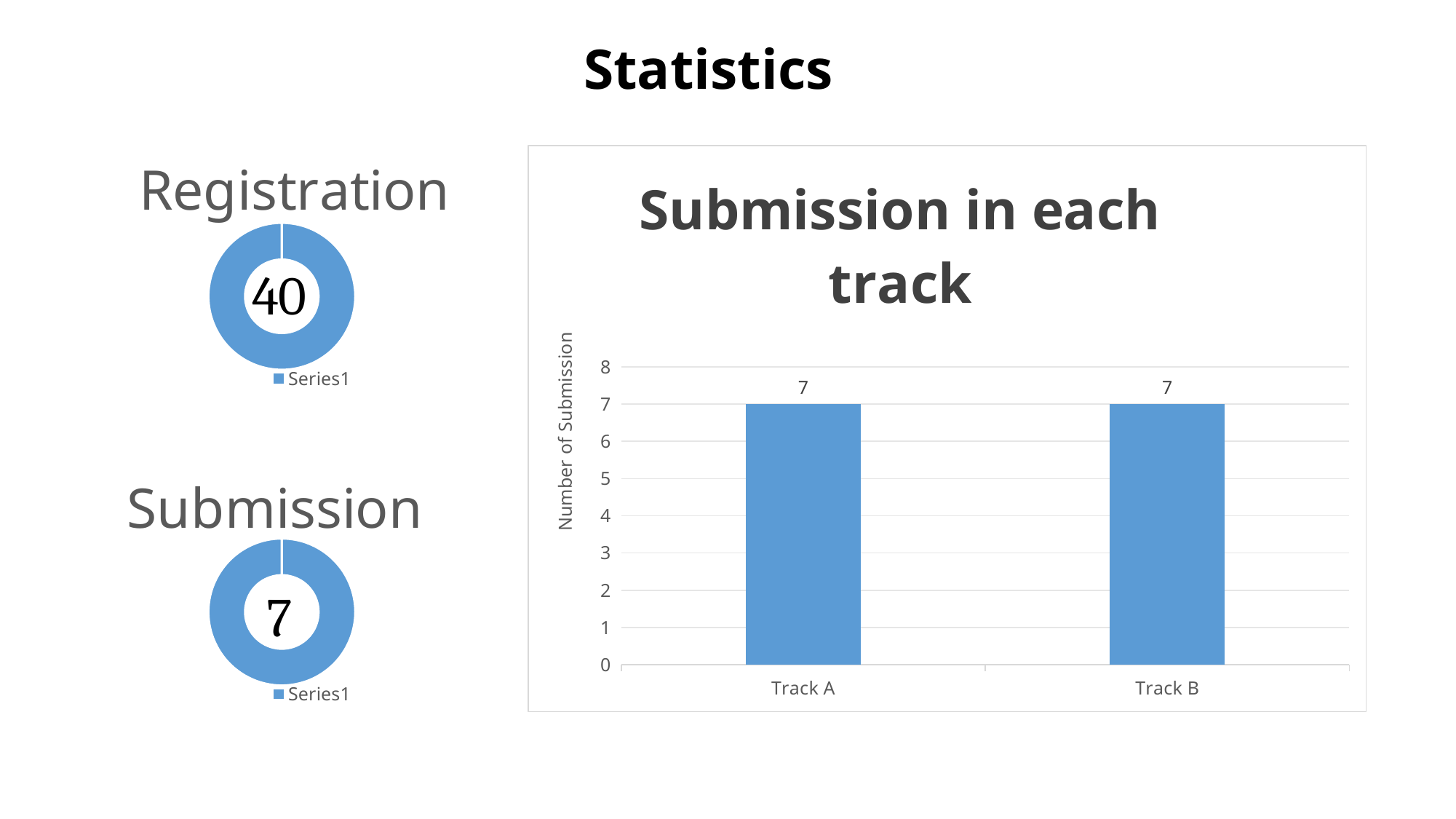
In the 'Submission in each track' bar chart, is the value for Track B greater or less than 5? greater What is the label on the vertical axis of the 'Submission in each track' bar chart? Number of Submission What kind of chart is the 'Registration' chart on the left of the slide? doughnut chart What number is shown in the centre of the 'Submission' doughnut chart on the left of the slide? 7 What kind of chart is the 'Submission in each track' chart? bar chart In the 'Submission in each track' bar chart, what is the difference between the values for Track A and Track B? 0 In the 'Submission in each track' bar chart, do the values rise, fall or stay the same from Track A to Track B? stay the same In the 'Submission in each track' bar chart, what is the value for Track B? 7 In the 'Submission in each track' chart, how many tracks are shown on the x axis? 2 What legend entry is shown under the 'Submission' doughnut chart on the left of the slide? Series1 In the 'Submission in each track' bar chart, what is the value for Track A? 7 What number is shown in the centre of the 'Registration' doughnut chart on the left of the slide? 40